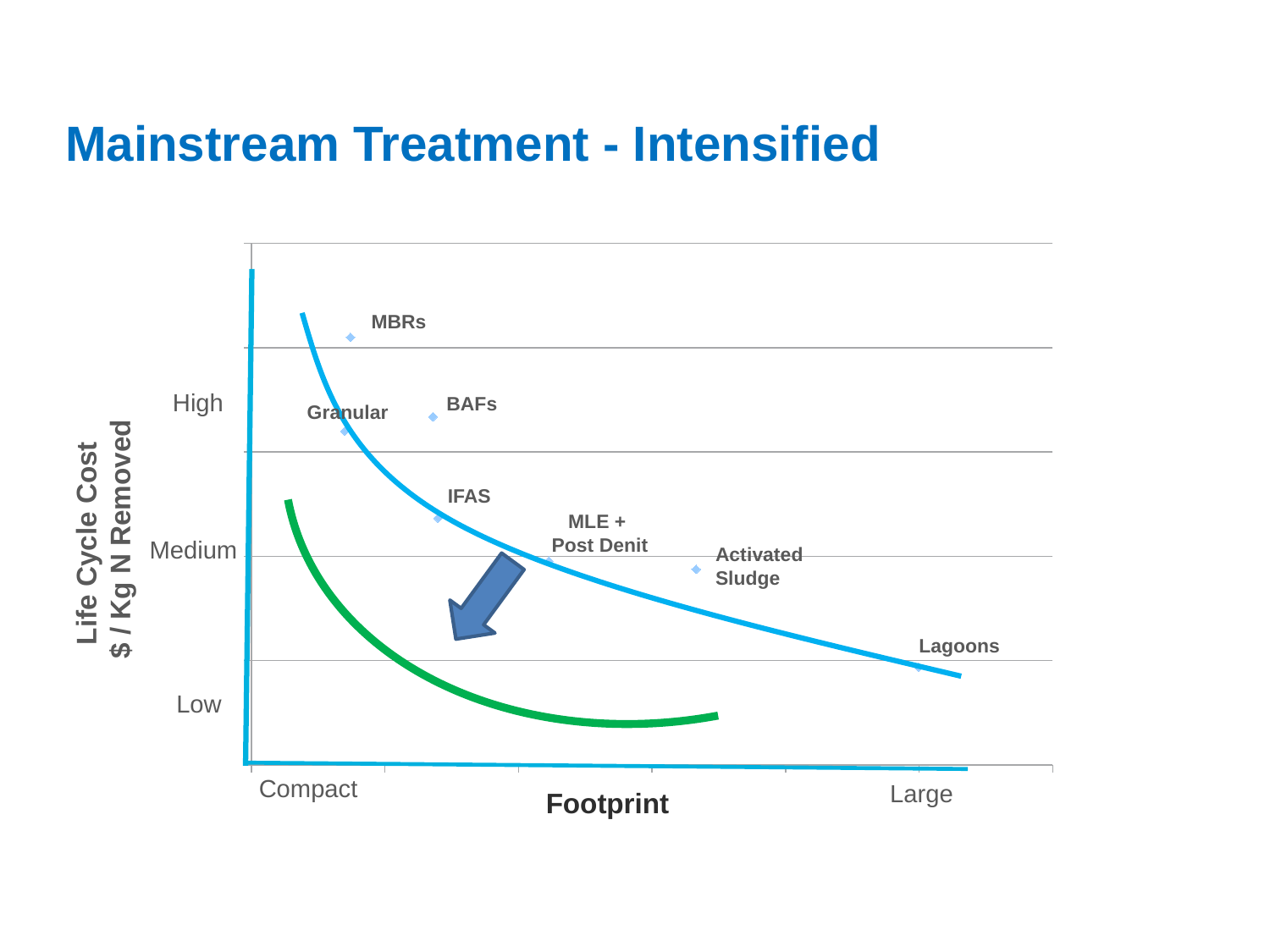
Which has a larger footprint, Activated Sludge or MLE + Post Denit? Activated Sludge Which treatment technology has the largest footprint on the chart? Lagoons What is the label of the y axis? Life Cycle Cost $ / Kg N Removed Which treatment technology has the lowest life cycle cost on the chart? Lagoons Is the life cycle cost of Activated Sludge above or below the Medium level? Below Which has a higher life cycle cost, MBRs or Lagoons? MBRs What kind of chart is shown on the slide? Scatter chart Which has a higher life cycle cost, BAFs or IFAS? BAFs How many labeled treatment technologies are plotted on the chart? 7 Which treatment technology has the highest life cycle cost on the chart? MBRs Does life cycle cost rise or fall as footprint increases from Compact to Large? Fall What is the label of the x axis? Footprint